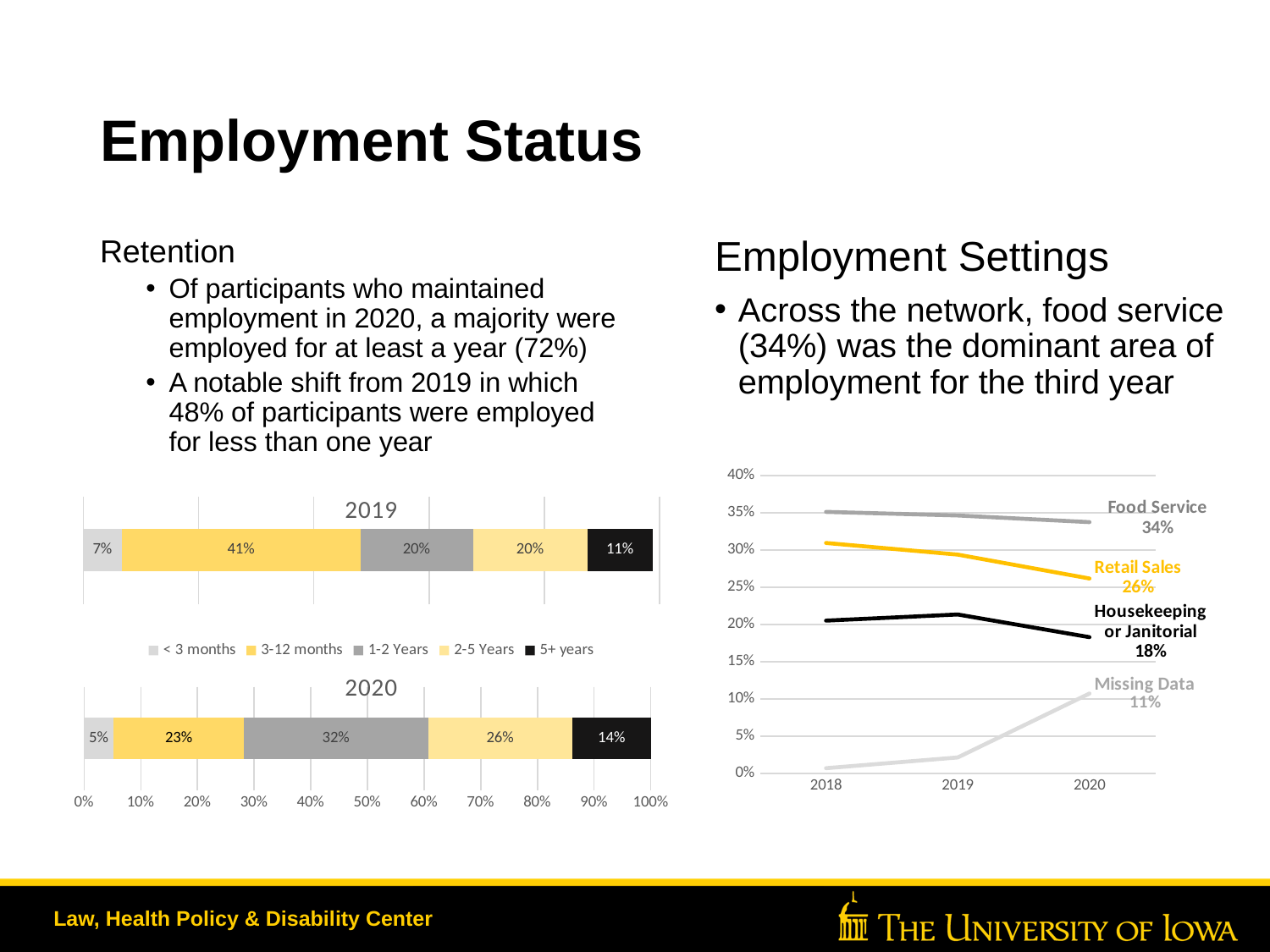
In the 2020 bar chart, which employment duration category has the largest share? 1-2 Years Comparing the 2019 and 2020 bar charts, which year has the larger share for 5+ years? 2020 In the 2019 bar chart, what percentage of participants were employed for 3-12 months? 41% How many series does the legend of the retention bar charts list? 5 In the 2019 bar chart, which employment duration category has the smallest share? < 3 months In the Employment Settings line chart, does the Missing Data line rise or fall from 2018 to 2020? Rise In the 2020 bar chart, what is the difference between the 2-5 Years share and the 5+ years share? 12% What kind of chart is the Employment Settings chart on the right? Line chart In the Employment Settings line chart, what is the value for Retail Sales in 2020? 26% In the Employment Settings line chart, is the value for Missing Data in 2018 greater or less than 5%? less In the Employment Settings line chart, which series has the highest value in 2020? Food Service In the 2020 bar chart, what percentage of participants were employed for 1-2 Years? 32%